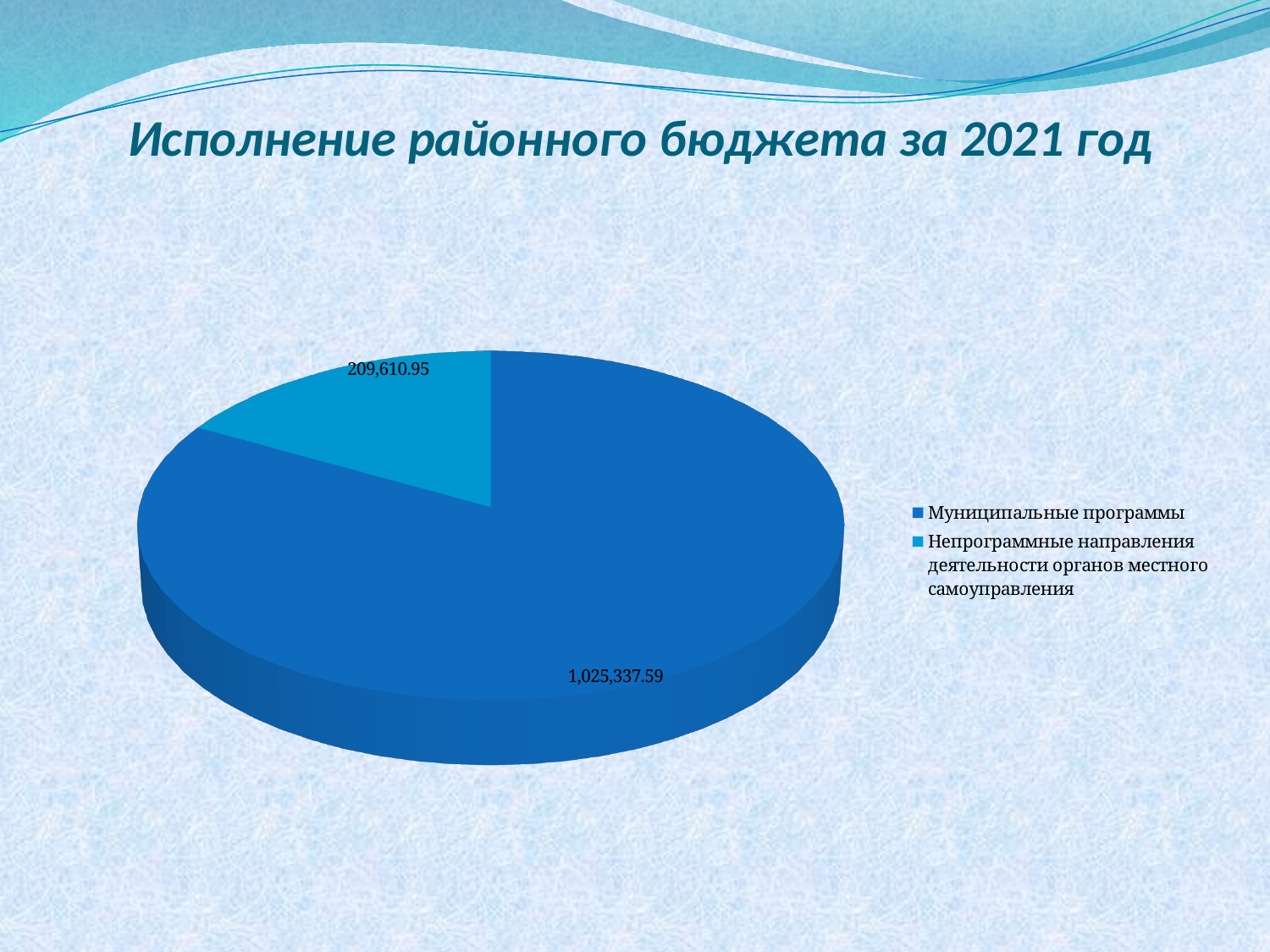
What is the title of the slide? Исполнение районного бюджета за 2021 год Which is larger: Муниципальные программы or Непрограммные направления деятельности органов местного самоуправления? Муниципальные программы How many slices does the pie chart have? 2 What kind of chart is shown on the slide? Pie chart Which category has the smallest slice of the pie? Непрограммные направления деятельности органов местного самоуправления What is the total of the two slices in the pie chart? 1,234,948.54 Which category has the largest slice of the pie? Муниципальные программы What is the difference between the value for Муниципальные программы and the value for Непрограммные направления деятельности органов местного самоуправления? 815,726.64 What is the value for Непрограммные направления деятельности органов местного самоуправления? 209,610.95 How many entries does the legend list? 2 What is the value for Муниципальные программы? 1,025,337.59